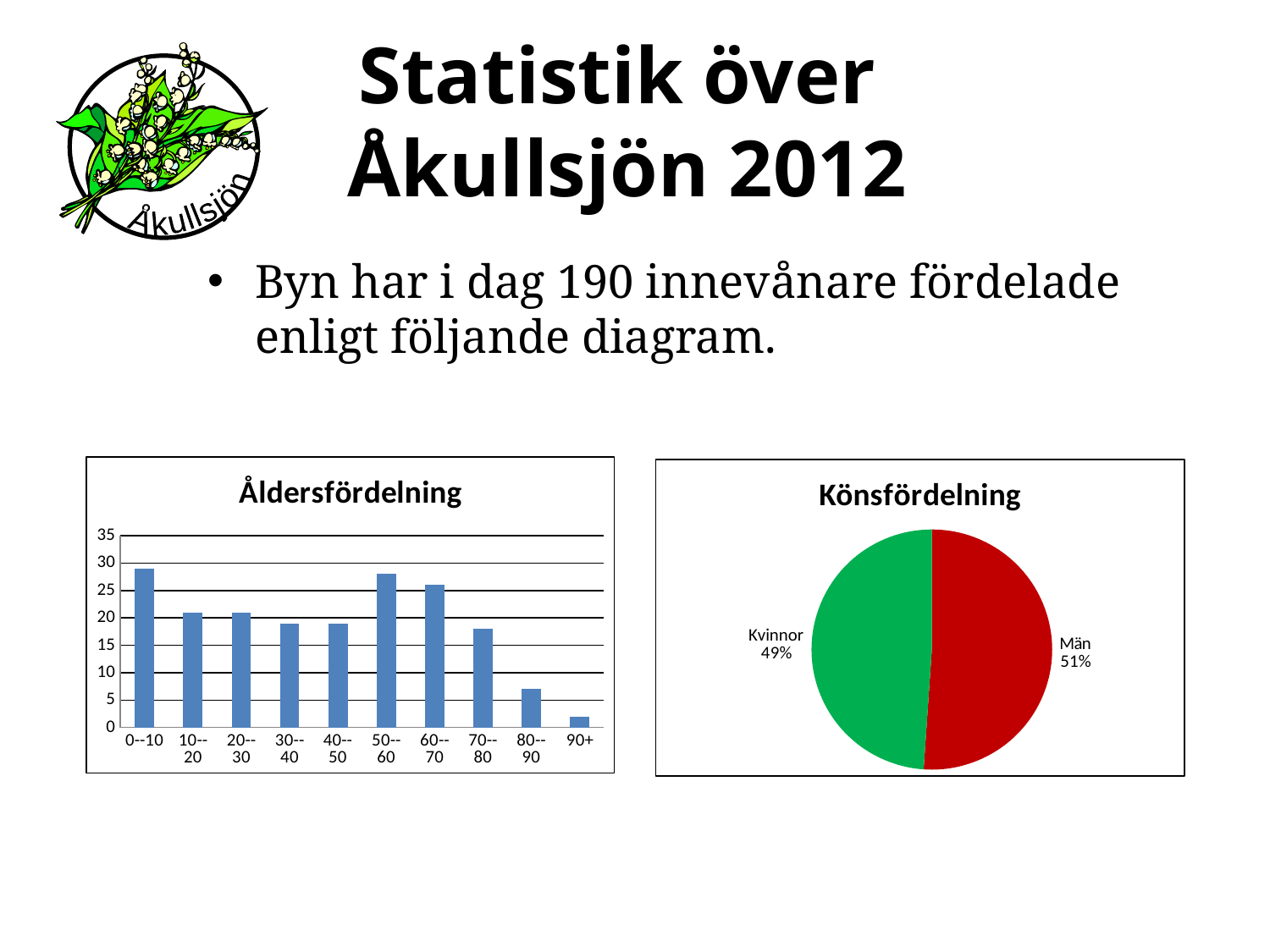
In the Könsfördelning chart, what colour is the Kvinnor slice? green In the Könsfördelning chart, what share of the pie is Kvinnor? 49% In the Åldersfördelning chart, which age category has the lowest value? 90+ In the Åldersfördelning chart, is the value for 30--40 greater or less than 15? greater What kind of chart is the Könsfördelning chart? pie chart What kind of chart is the Åldersfördelning chart? bar chart In the Åldersfördelning chart, is the value for 0--10 greater or less than 25? greater In the Åldersfördelning chart, how many age categories are shown on the x axis? 10 In the Åldersfördelning chart, which is larger, the value for 0--10 or the value for 80--90? 0--10 In the Könsfördelning chart, what share of the pie is Män? 51% In the Åldersfördelning chart, is the value for 90+ greater or less than 5? less In the Könsfördelning chart, which slice is the largest? Män